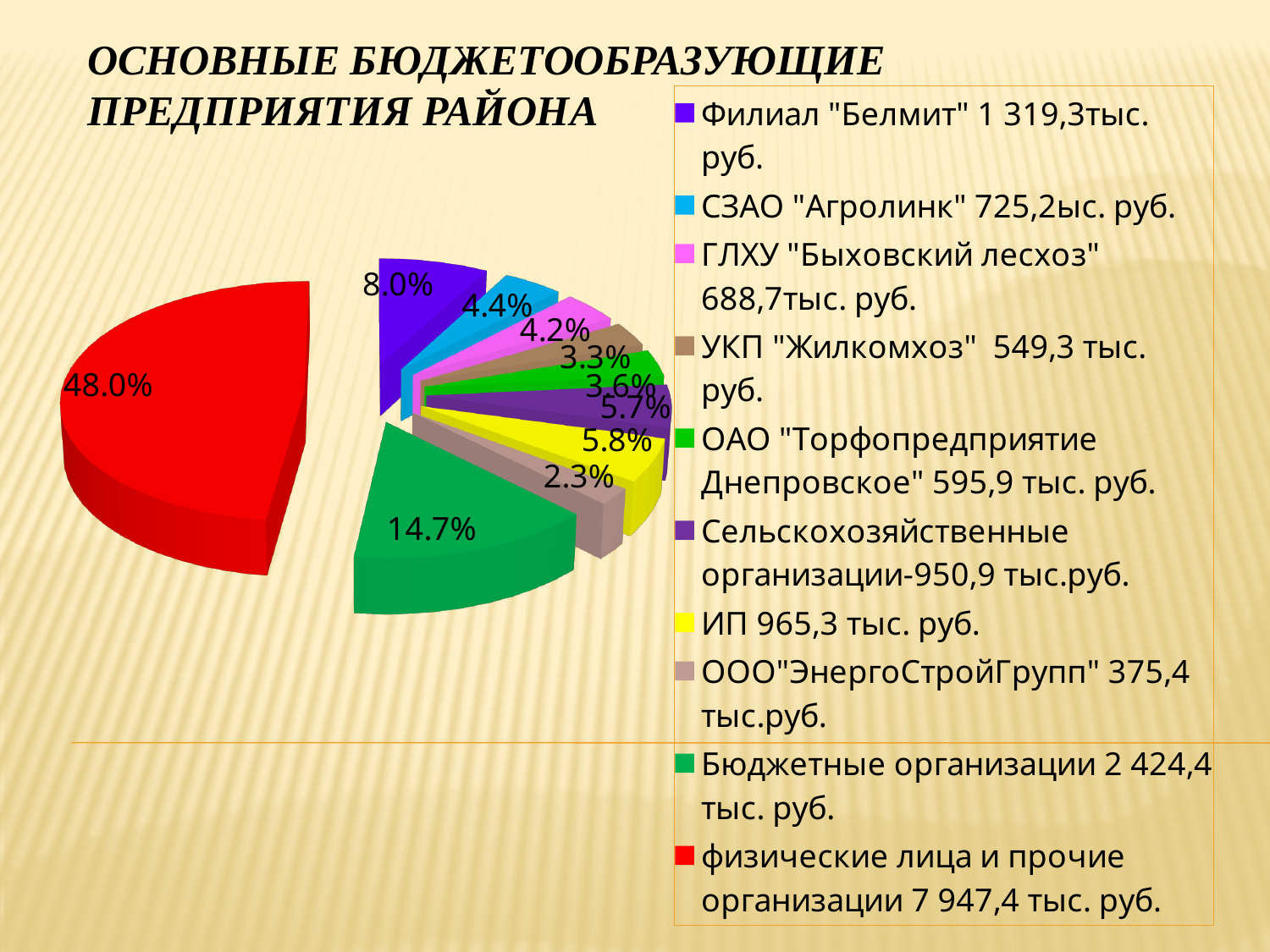
What share of the pie is labelled for физические лица и прочие организации? 48.0% What is the difference in percentage points between the share for физические лица и прочие организации and the share for Бюджетные организации? 33.3 According to the legend, what is the amount for УКП "Жилкомхоз"? 549,3 тыс. руб. Which category has the smallest slice of the pie? ООО "ЭнергоСтройГрупп" Which category has the largest slice of the pie? физические лица и прочие организации What percentage is shown for Филиал "Белмит"? 8.0% What colour is the slice for Бюджетные организации? green What kind of chart is shown on the slide? pie chart What share of the pie is labelled for Бюджетные организации? 14.7% Which is larger: the share for Бюджетные организации or the share for Филиал "Белмит"? Бюджетные организации How many slices does the pie chart have? 10 What percentage is shown for ООО "ЭнергоСтройГрупп"? 2.3%